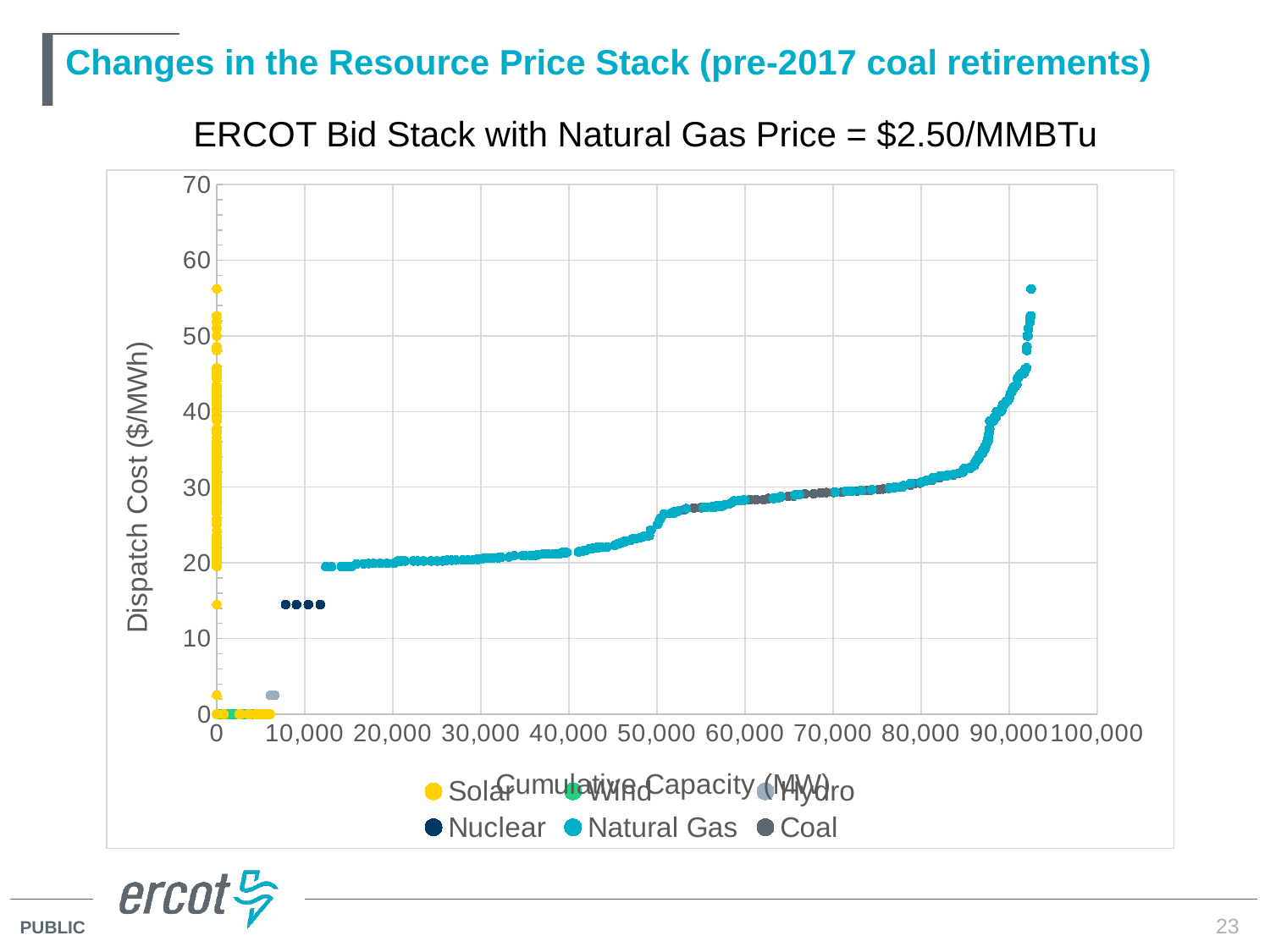
Which series has the lower dispatch cost, Hydro or Nuclear? Hydro What is the label of the vertical axis? Dispatch Cost ($/MWh) What is the title of the chart? ERCOT Bid Stack with Natural Gas Price = $2.50/MMBTu What kind of chart is shown on the slide? scatter chart Is the dispatch cost of the Hydro point greater or less than 10? less Which series has the higher dispatch cost, Nuclear or Natural Gas? Natural Gas Is the dispatch cost of the Nuclear points greater or less than 20? less How many series does the legend list? 6 Do the Natural Gas points rise or fall in dispatch cost as cumulative capacity increases? rise Is the highest dispatch cost among the Natural Gas points greater or less than 50? greater What is the highest value shown on the vertical axis? 70